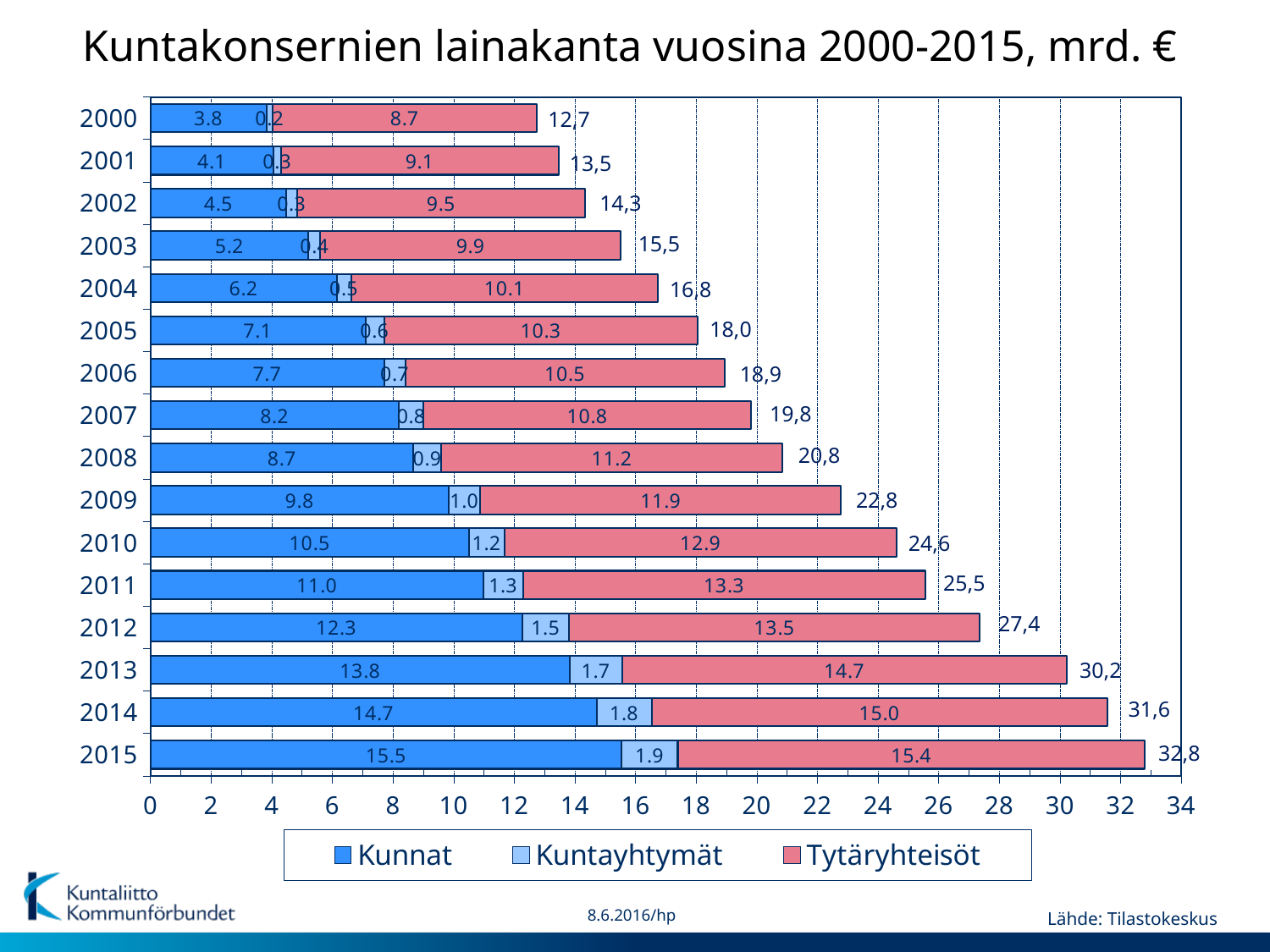
How many years are shown on the chart? 16 What is the total loan stock shown for 2010? 24,6 What is the value for Kuntayhtymät in 2012? 1.5 What type of chart is shown on the slide? stacked bar chart What is the value for Tytäryhteisöt in 2008? 11.2 What is the difference between the Kunnat values for 2015 and 2000? 11.7 Which year has the lowest total loan stock? 2000 Which year has the highest total loan stock? 2015 Which is larger in 2013, the Kunnat value or the Tytäryhteisöt value? Tytäryhteisöt What is the value for Kunnat in 2015? 15.5 Do the total values rise or fall from 2000 to 2015? rise How many series does the legend list? 3